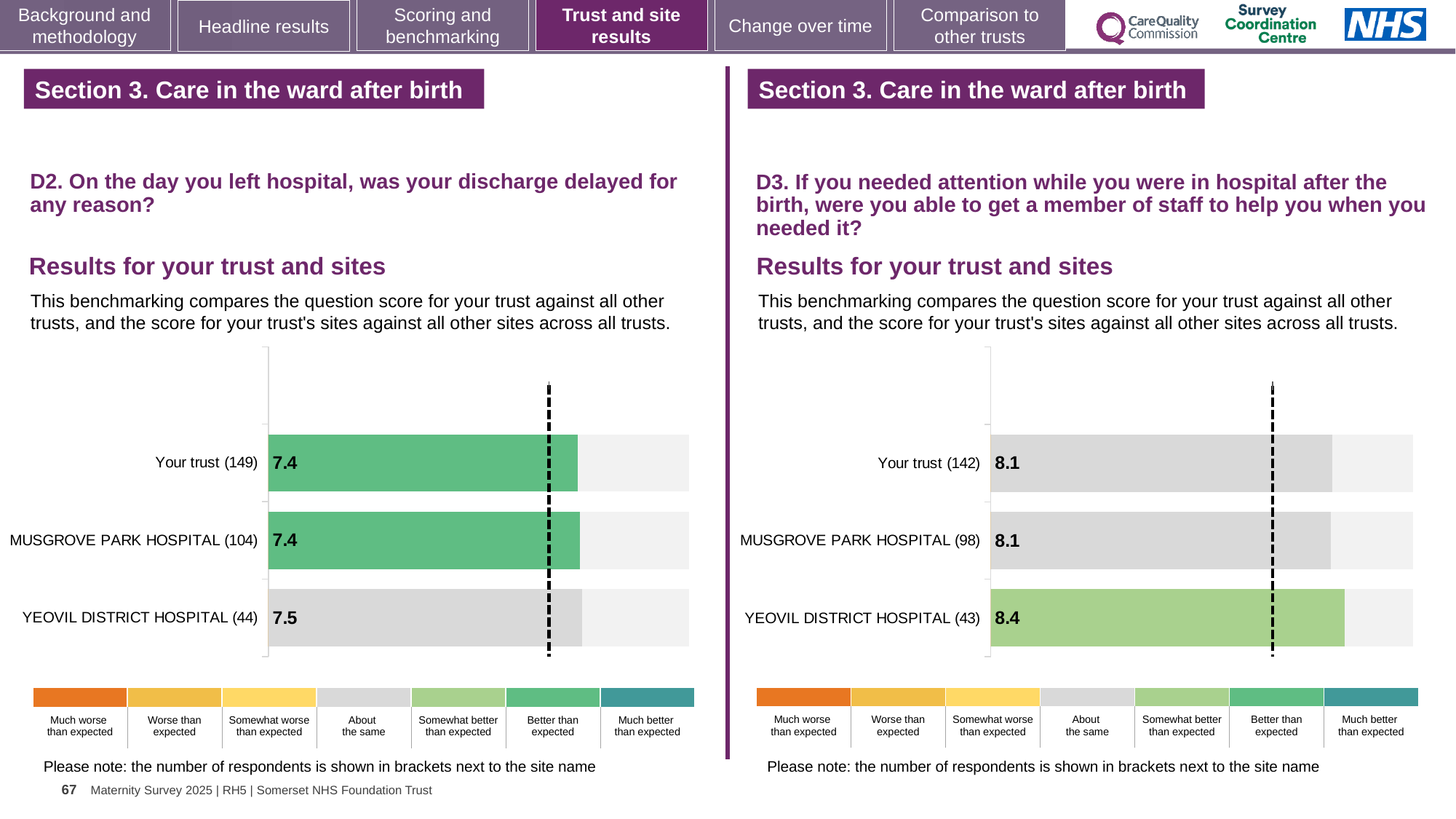
In the D2 chart on the left, which site or trust has the highest score? YEOVIL DISTRICT HOSPITAL What type of chart is used for the D3 results on the right? bar chart In the D2 chart on the left, how many respondents are shown in brackets for MUSGROVE PARK HOSPITAL? 104 In the D2 chart on the left, what is the score for Your trust? 7.4 In the D2 chart on the left, what is the score for YEOVIL DISTRICT HOSPITAL? 7.5 In the D3 chart on the right, which benchmark category does the colour of the YEOVIL DISTRICT HOSPITAL bar correspond to? Somewhat better than expected In the D3 chart on the right, what is the score for MUSGROVE PARK HOSPITAL? 8.1 In the D3 chart on the right, what is the difference between the scores for YEOVIL DISTRICT HOSPITAL and Your trust? 0.3 How many bars are shown in the D2 chart on the left? 3 In the D3 chart on the right, which site or trust has the highest score? YEOVIL DISTRICT HOSPITAL In the D3 chart on the right, what is the score for YEOVIL DISTRICT HOSPITAL? 8.4 In the D2 chart on the left, is the score for YEOVIL DISTRICT HOSPITAL higher or lower than the score for MUSGROVE PARK HOSPITAL? higher